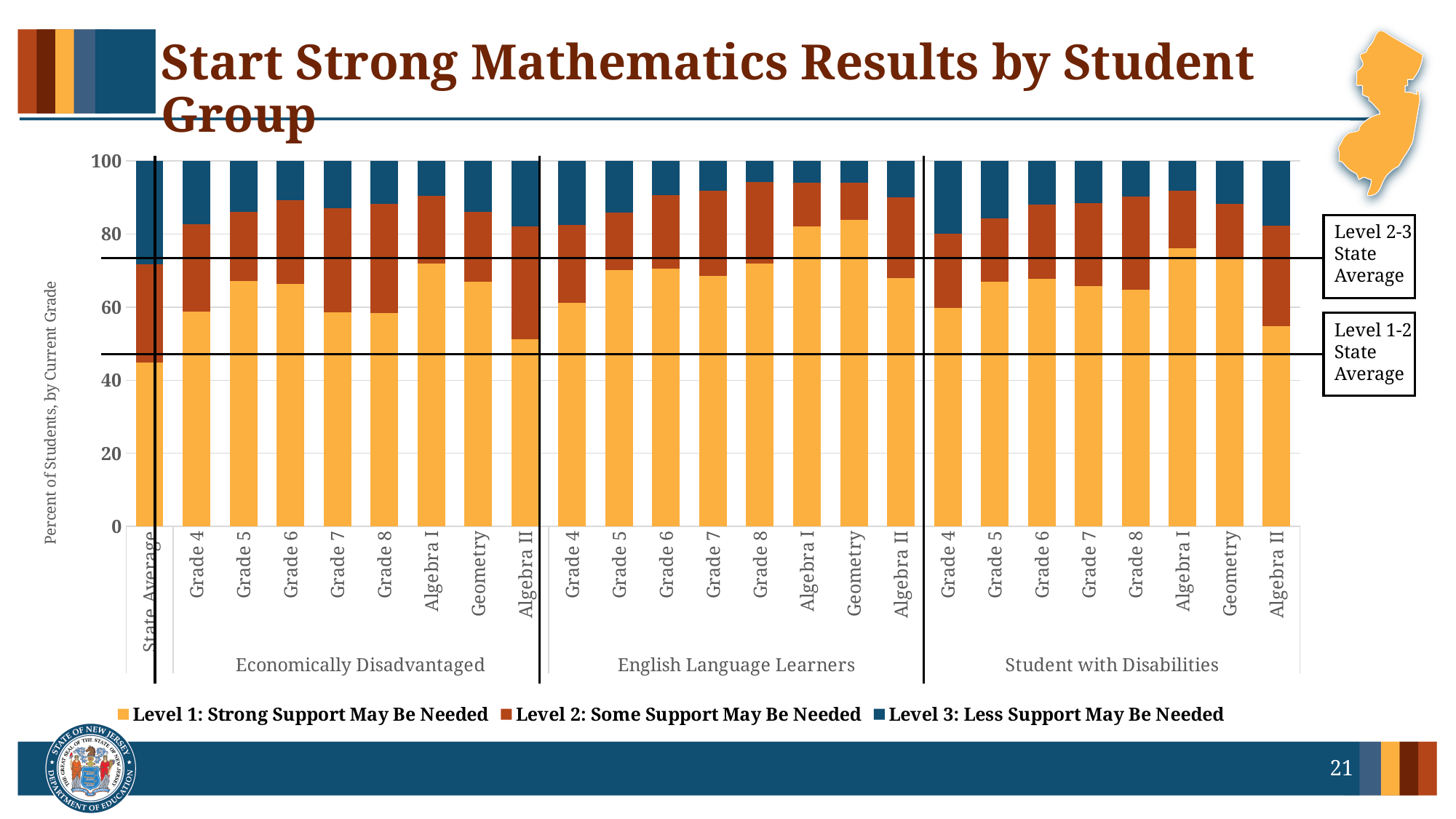
What is the label of the y axis? Percent of Students, by Current Grade How many series does the legend list? 3 Is the Level 1 value for Geometry in the English Language Learners group greater or less than 80? greater Within the Economically Disadvantaged group, which category has the lowest Level 1 share? Algebra II How many student groups are shown along the x axis, excluding the State Average? 3 Is the Level 1 value for Algebra II in the Economically Disadvantaged group greater or less than 60? less What kind of chart is shown on the slide? Stacked bar chart What is the title of the chart on the slide? Start Strong Mathematics Results by Student Group Is the Level 1 value for the State Average bar greater or less than 60? less How many bars are plotted in the chart, including the State Average bar? 25 Which has the larger Level 1 share: Geometry in the English Language Learners group or Algebra II in the Economically Disadvantaged group? Geometry in the English Language Learners group What is the total height of each stacked bar according to the y axis? 100